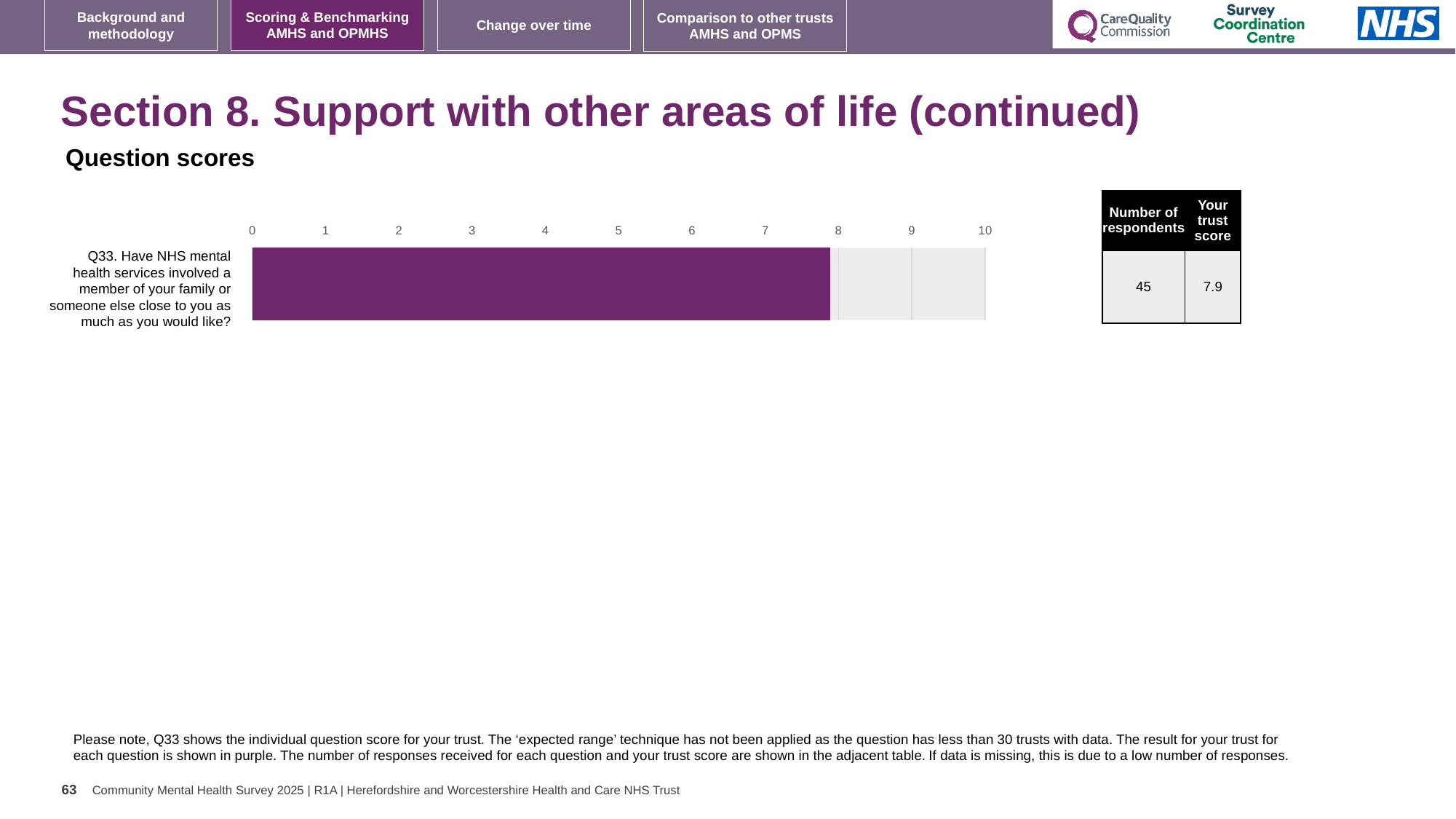
Is the value of the bar for Q33 greater or less than 8? less What kind of chart is shown on the slide? Bar chart How many respondents answered Q33 according to the table next to the chart? 45 Is the value of the bar for Q33 greater or less than 5? greater What is the trust score for Q33 shown in the adjacent table? 7.9 What is the maximum value shown on the chart's axis? 10 What colour is the bar for Q33? Purple Is the value of the bar for Q33 greater or less than 7? greater How many questions (categories) are plotted in the chart? 1